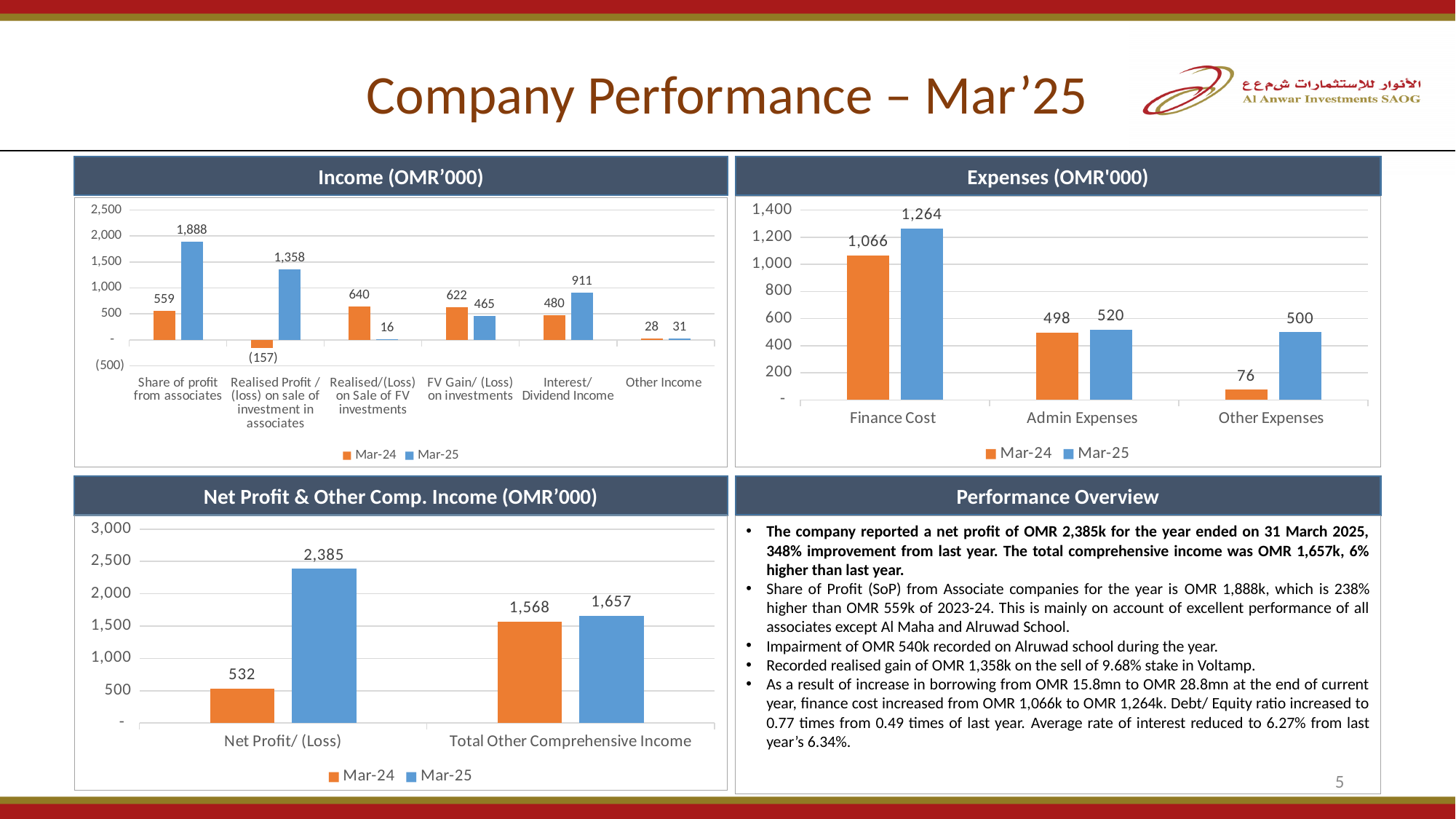
In the Net Profit & Other Comp. Income (OMR'000) chart, what is the Mar-25 value for Net Profit/ (Loss)? 2,385 In the Expenses (OMR'000) chart, how many series does the legend list? 2 What kind of chart is the Net Profit & Other Comp. Income (OMR'000) chart? Bar chart In the Income (OMR'000) chart, what is the Mar-25 value for Share of profit from associates? 1,888 In the Income (OMR'000) chart, what is the Mar-24 value for Realised Profit / (loss) on sale of investment in associates? (157) In the Income (OMR'000) chart, which category has the highest Mar-25 value? Share of profit from associates In the Income (OMR'000) chart, how many categories are shown on the x axis? 6 In the Income (OMR'000) chart, what is the difference between the Mar-25 and Mar-24 values for Interest/ Dividend Income? 431 In the Expenses (OMR'000) chart, what is the Mar-24 value for Other Expenses? 76 In the Expenses (OMR'000) chart, which category has the lowest Mar-24 value? Other Expenses In the Expenses (OMR'000) chart, what is the difference between the Mar-25 and Mar-24 values for Finance Cost? 198 In the Net Profit & Other Comp. Income (OMR'000) chart, which is larger for Total Other Comprehensive Income, Mar-24 or Mar-25? Mar-25